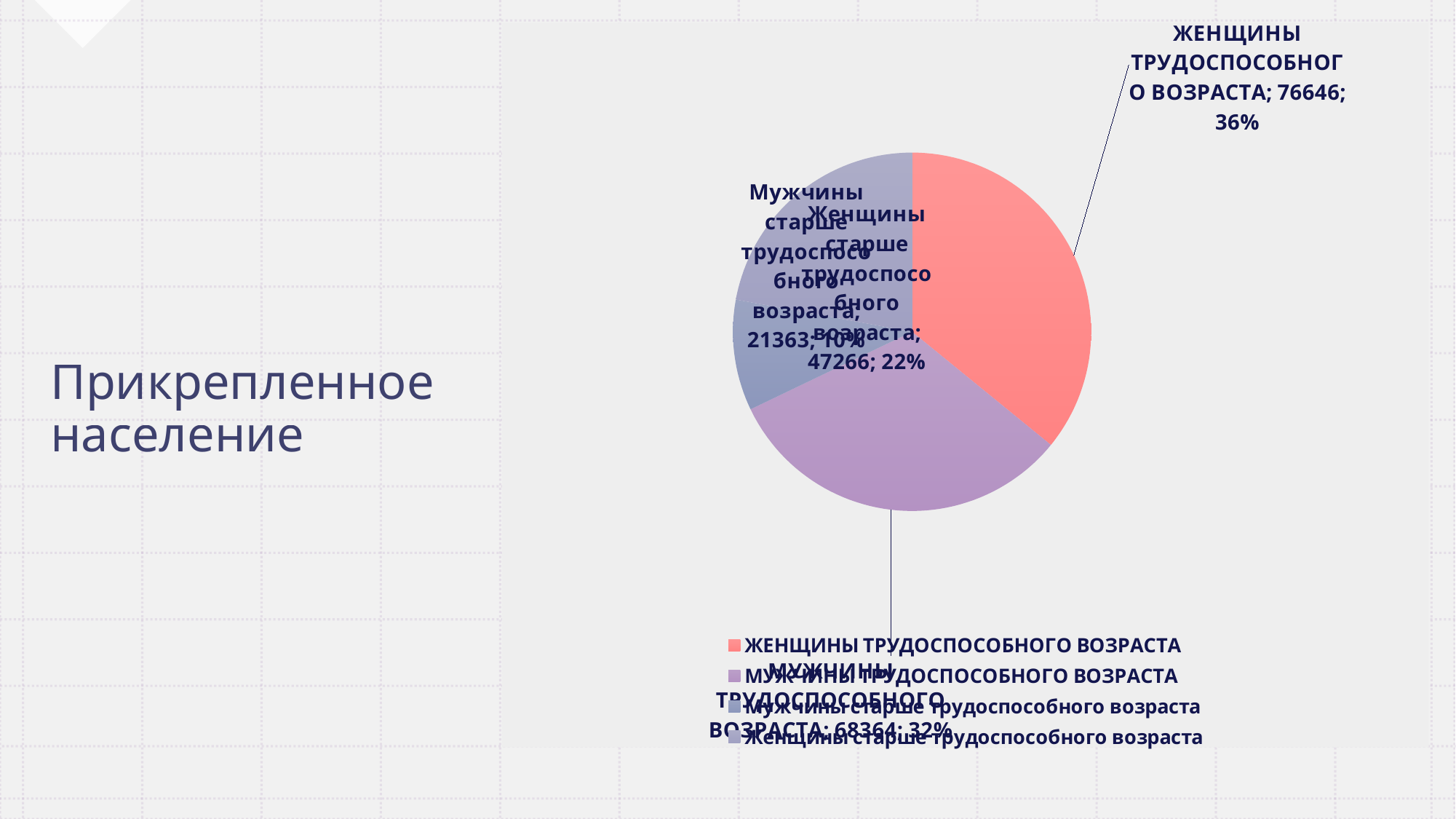
How many slices does the pie chart have? 4 Which is larger: ЖЕНЩИНЫ ТРУДОСПОСОБНОГО ВОЗРАСТА or Женщины старше трудоспособного возраста? ЖЕНЩИНЫ ТРУДОСПОСОБНОГО ВОЗРАСТА What is the value for ЖЕНЩИНЫ ТРУДОСПОСОБНОГО ВОЗРАСТА? 76646 What is the value for Женщины старше трудоспособного возраста? 47266 How many entries does the legend list? 4 What share of the pie is ЖЕНЩИНЫ ТРУДОСПОСОБНОГО ВОЗРАСТА? 36% Which category has the largest slice of the pie? ЖЕНЩИНЫ ТРУДОСПОСОБНОГО ВОЗРАСТА What share of the pie is Мужчины старше трудоспособного возраста? 10% What share of the pie is Женщины старше трудоспособного возраста? 22% Which category has the smallest slice of the pie? Мужчины старше трудоспособного возраста What kind of chart is shown on the slide? pie chart What is the difference between the values for ЖЕНЩИНЫ ТРУДОСПОСОБНОГО ВОЗРАСТА and Женщины старше трудоспособного возраста? 29380